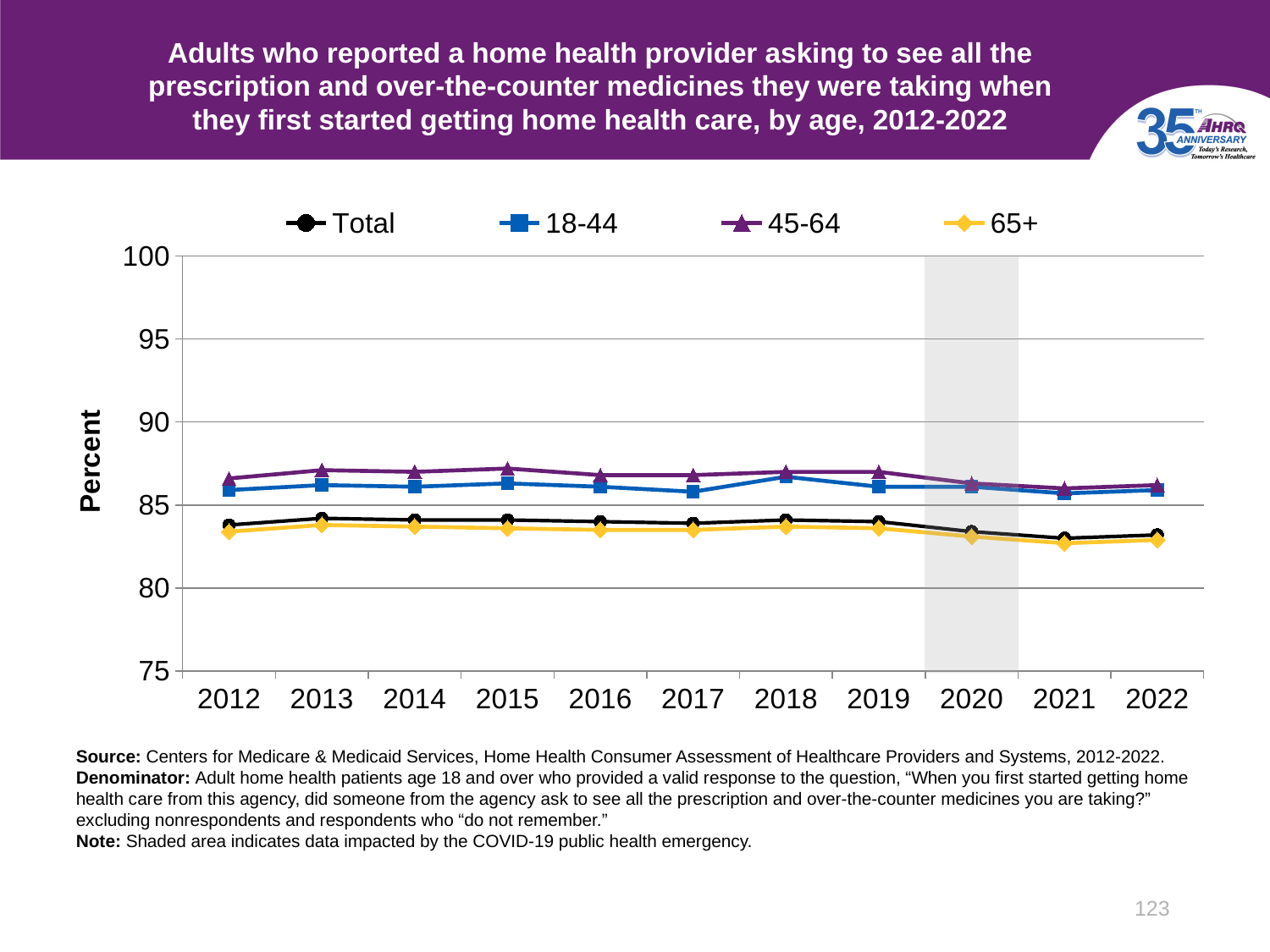
Is the value for the 18-44 group in 2018 greater or less than 90? less Which age group has the lowest value in 2021? 65+ Is the value for the 45-64 group in 2015 greater or less than 85? greater According to the note, what does the shaded area on the chart indicate? Data impacted by the COVID-19 public health emergency In 2012, which is larger: the value for 18-44 or the value for Total? 18-44 Did the value for the 65+ group rise or fall from 2019 to 2021? fall Is the value for the 65+ group in 2021 greater or less than 85? less How many series does the legend list? 4 Which age group has the highest value in 2015? 45-64 How many years are plotted along the x axis? 11 What kind of chart is shown on the slide? line chart What is the label on the y axis? Percent